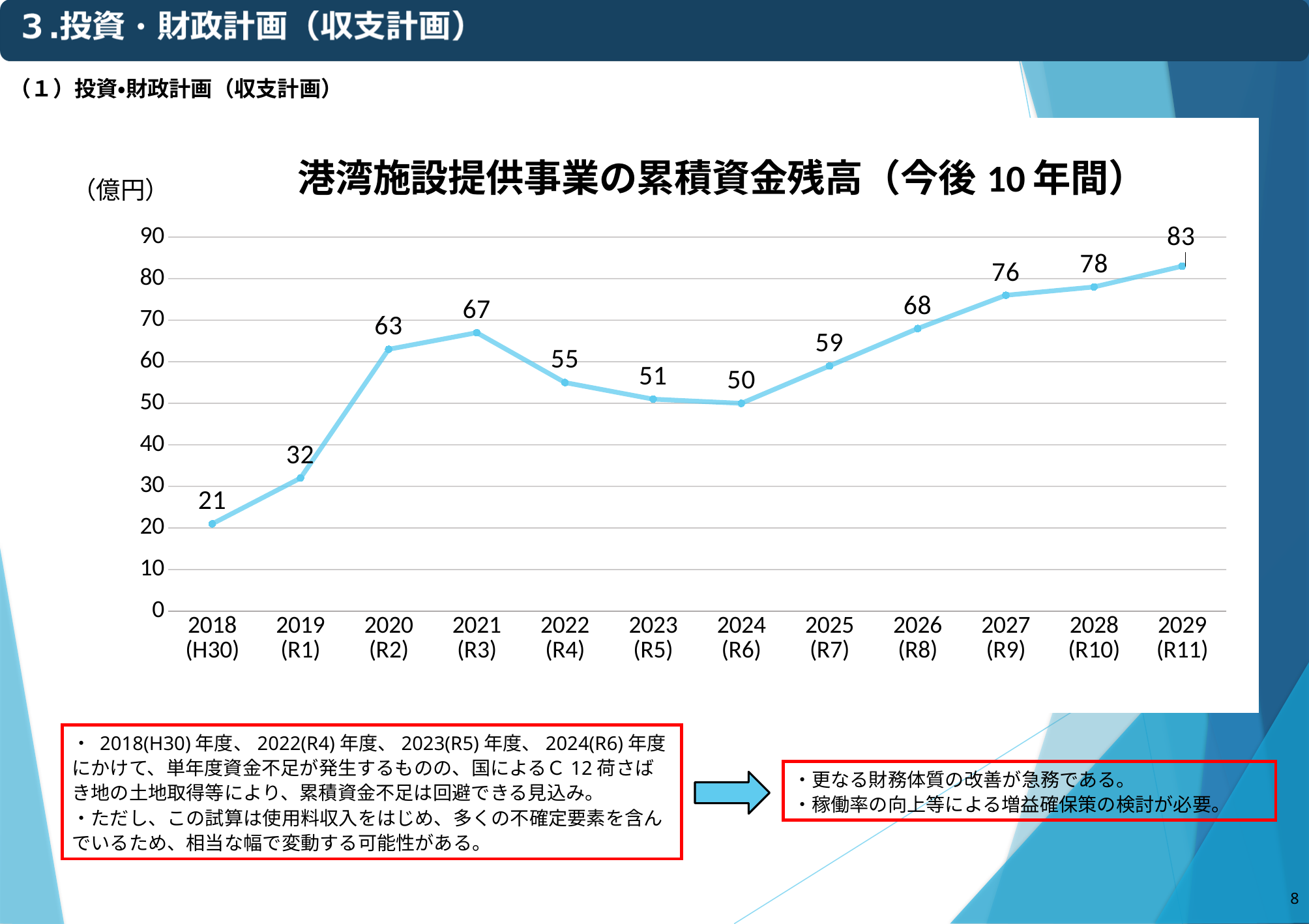
Do the values rise or fall from 2024 (R6) to 2029 (R11)? rise What is the value for 2020 (R2)? 63 What unit is shown at the top left of the chart? 億円 What is the difference between the values for 2021 (R3) and 2022 (R4)? 12 What kind of chart is this? line chart Which is larger, the value for 2020 (R2) or the value for 2025 (R7)? 2020 (R2) What is the difference between the values for 2029 (R11) and 2018 (H30)? 62 Which year has the lowest value? 2018 (H30) Which year has the highest value? 2029 (R11) How many years are plotted on the x axis? 12 What is the value for 2029 (R11)? 83 What is the value for 2024 (R6)? 50